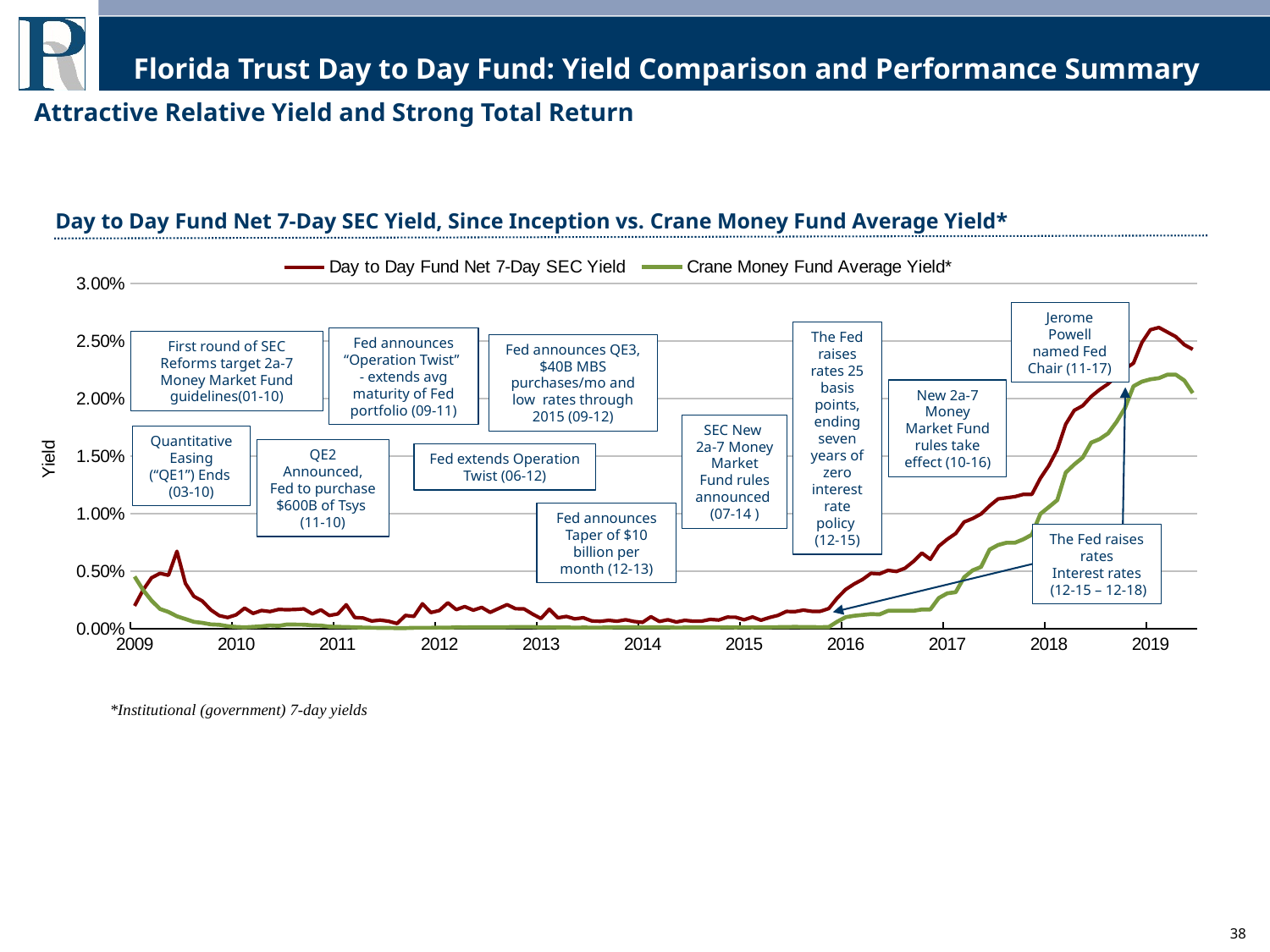
How many year labels are shown on the x axis? 11 In 2019, which series has the higher yield, the Day to Day Fund Net 7-Day SEC Yield or the Crane Money Fund Average Yield? Day to Day Fund Net 7-Day SEC Yield Does the Day to Day Fund Net 7-Day SEC Yield rise or fall between 2016 and the start of 2019? rise Is the Crane Money Fund Average Yield at the start of 2017 greater or less than 0.50%? less What kind of chart is shown on the slide? line chart How many series does the legend list? 2 Is the Day to Day Fund Net 7-Day SEC Yield in 2014 greater or less than 0.50%? less Which series is drawn in green? Crane Money Fund Average Yield* Is the Day to Day Fund Net 7-Day SEC Yield at the start of 2018 greater or less than 1.00%? greater What is the title of the chart? Day to Day Fund Net 7-Day SEC Yield, Since Inception vs. Crane Money Fund Average Yield*